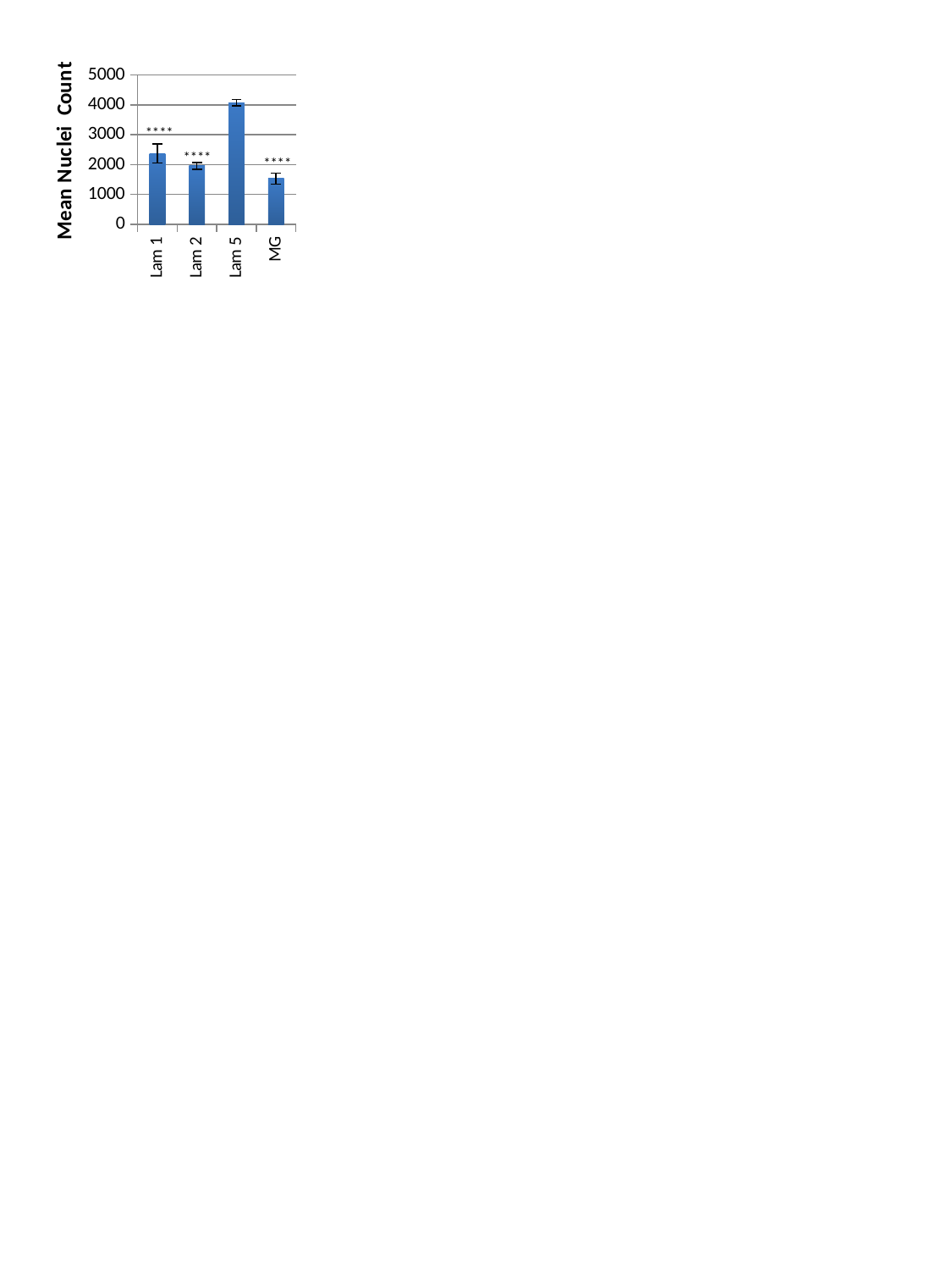
Is the value for Lam 1 greater or less than 2000? greater Which has a larger mean nuclei count, Lam 1 or Lam 2? Lam 1 Which has a larger mean nuclei count, Lam 5 or MG? Lam 5 What is the title of the y axis? Mean Nuclei Count What kind of chart is shown on the slide? bar chart Which bars are marked with asterisks (****) above them? Lam 1, Lam 2 and MG Is the value for MG greater or less than 2000? less Which has a larger mean nuclei count, Lam 1 or MG? Lam 1 How many categories are plotted on the x axis? 4 Is the value for Lam 5 greater or less than 3000? greater Which category has the highest mean nuclei count? Lam 5 Which category has the lowest mean nuclei count? MG